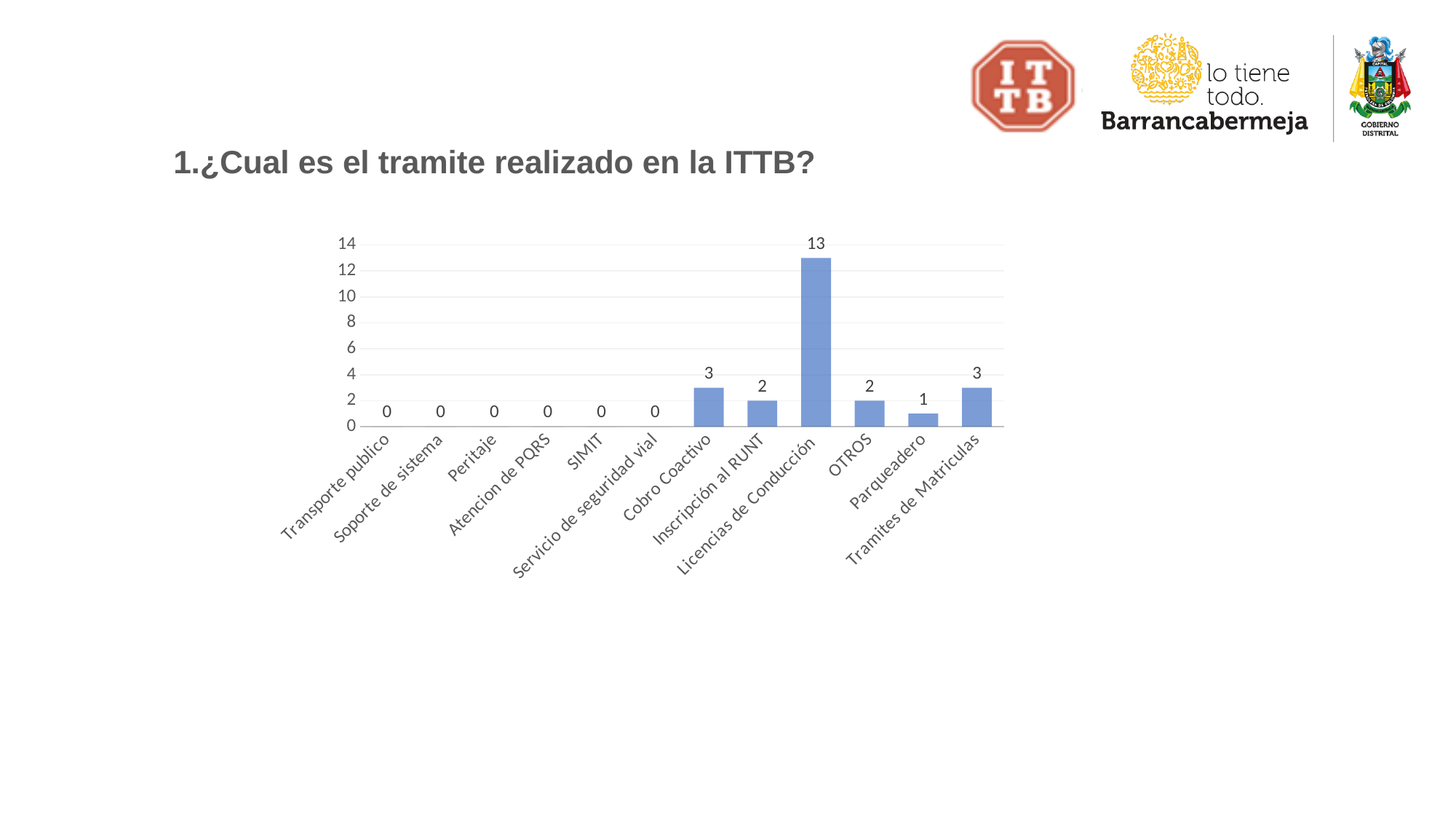
What is the value for Licencias de Conducción? 13 Is the value for Licencias de Conducción greater or less than 10? greater How many categories are shown on the x axis? 12 What is the value for Inscripción al RUNT? 2 How many categories have a value of 0? 6 What kind of chart is shown on the slide? bar chart What is the difference between the values for Licencias de Conducción and Tramites de Matriculas? 10 Which category has the highest value? Licencias de Conducción What is the title of the question shown above the chart? 1.¿Cual es el tramite realizado en la ITTB? What is the value for Parqueadero? 1 Which is larger, the value for OTROS or the value for Parqueadero? OTROS What is the value for Cobro Coactivo? 3